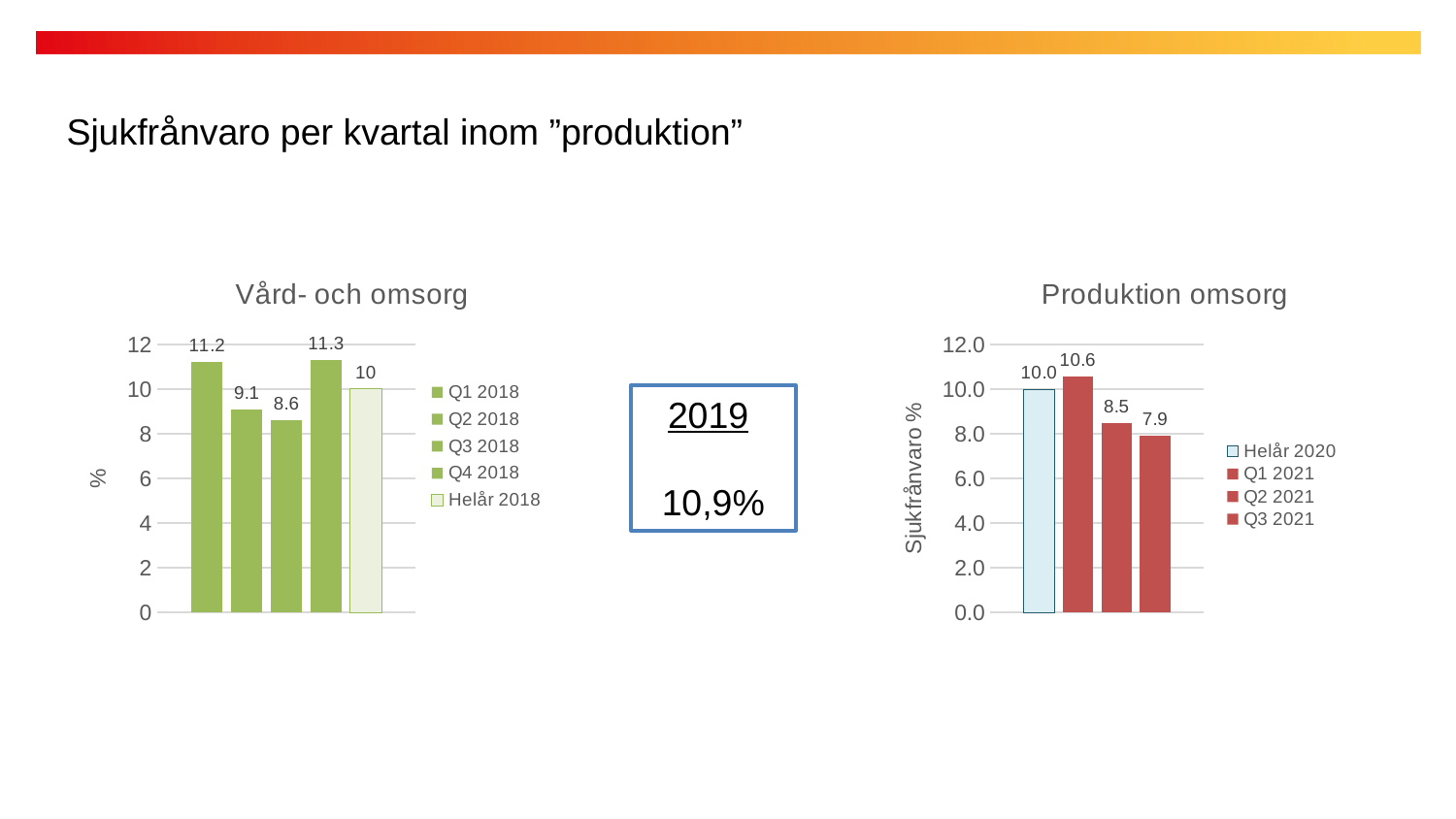
In the "Produktion omsorg" chart, which series has the lowest value? Q3 2021 In the "Vård- och omsorg" chart, how many series does the legend list? 5 In the "Produktion omsorg" chart, which is larger, Helår 2020 or Q2 2021? Helår 2020 What kind of chart is the "Produktion omsorg" chart? Bar chart In the "Vård- och omsorg" chart, which series has the highest value? Q4 2018 In the "Produktion omsorg" chart, what is the value for Q3 2021? 7.9 In the "Vård- och omsorg" chart, what is the difference between Q4 2018 and Q3 2018? 2.7 In the "Vård- och omsorg" chart, what is the value for Q1 2018? 11.2 In the "Vård- och omsorg" chart, which series has the lowest value? Q3 2018 In the "Produktion omsorg" chart, what is the value for Q1 2021? 10.6 In the "Produktion omsorg" chart, what is the difference between Q1 2021 and Q2 2021? 2.1 In the "Vård- och omsorg" chart, what is the value for Helår 2018? 10